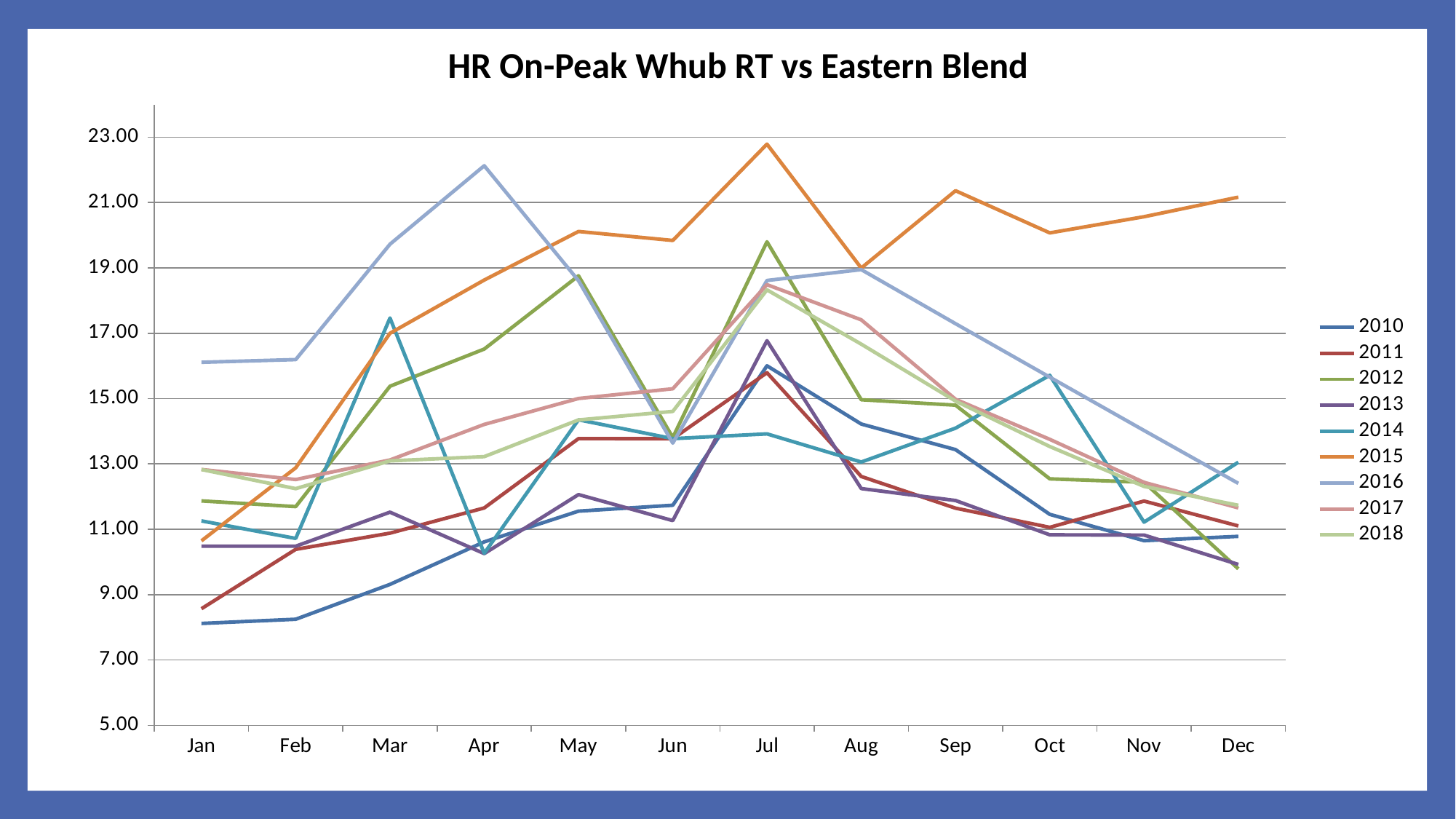
What is the title of the chart? HR On-Peak Whub RT vs Eastern Blend Does the 2016 series rise or fall from Jul to Dec? fall How many months are shown along the x axis? 12 Is the value for 2010 in Jan greater or less than 9.00? less What kind of chart is shown on the slide? line chart Which series has the highest value in Apr? 2016 In Sep, which series has the larger value, 2015 or 2010? 2015 Which series has the highest value in Jul? 2015 Is the value for 2015 in Jul greater or less than 21.00? greater Is the value for 2013 in Dec greater or less than 11.00? less How many series does the legend list? 9 Which series has the lowest value in Jan? 2010